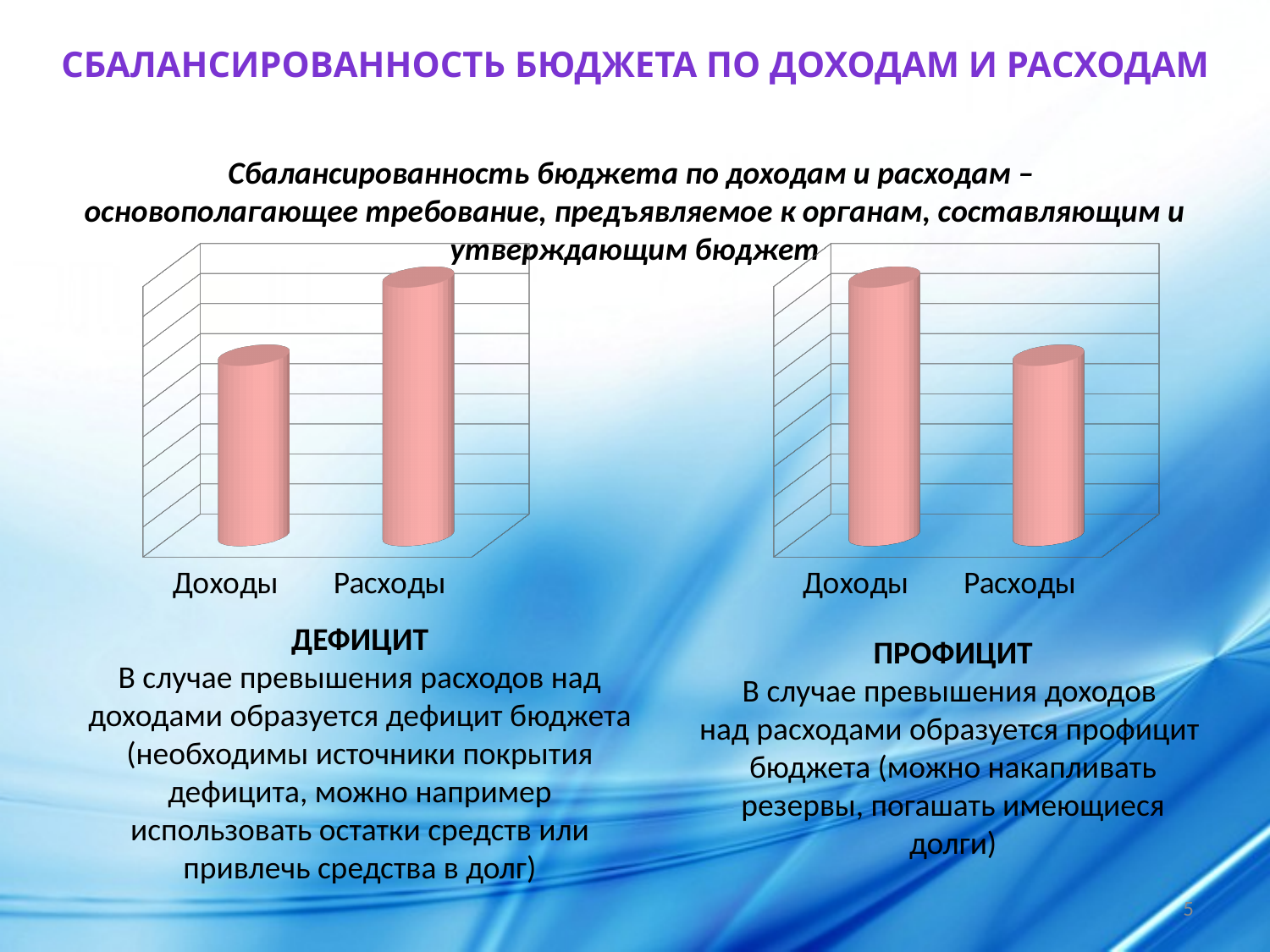
In the right chart, which is larger: Доходы or Расходы? Доходы What kind of chart is the right chart on the slide? bar chart What kind of chart is the left chart on the slide? bar chart What colour are the bars in both charts? pink In the right chart, do the bars rise or fall from Доходы to Расходы? fall How many categories does the right chart show? 2 In the left chart, which category has the highest bar? Расходы How many categories does the left chart show? 2 In the right chart, which category has the lowest bar? Расходы In the left chart, which is larger: Доходы or Расходы? Расходы In the left chart, which category has the lowest bar? Доходы In the right chart, which category has the highest bar? Доходы